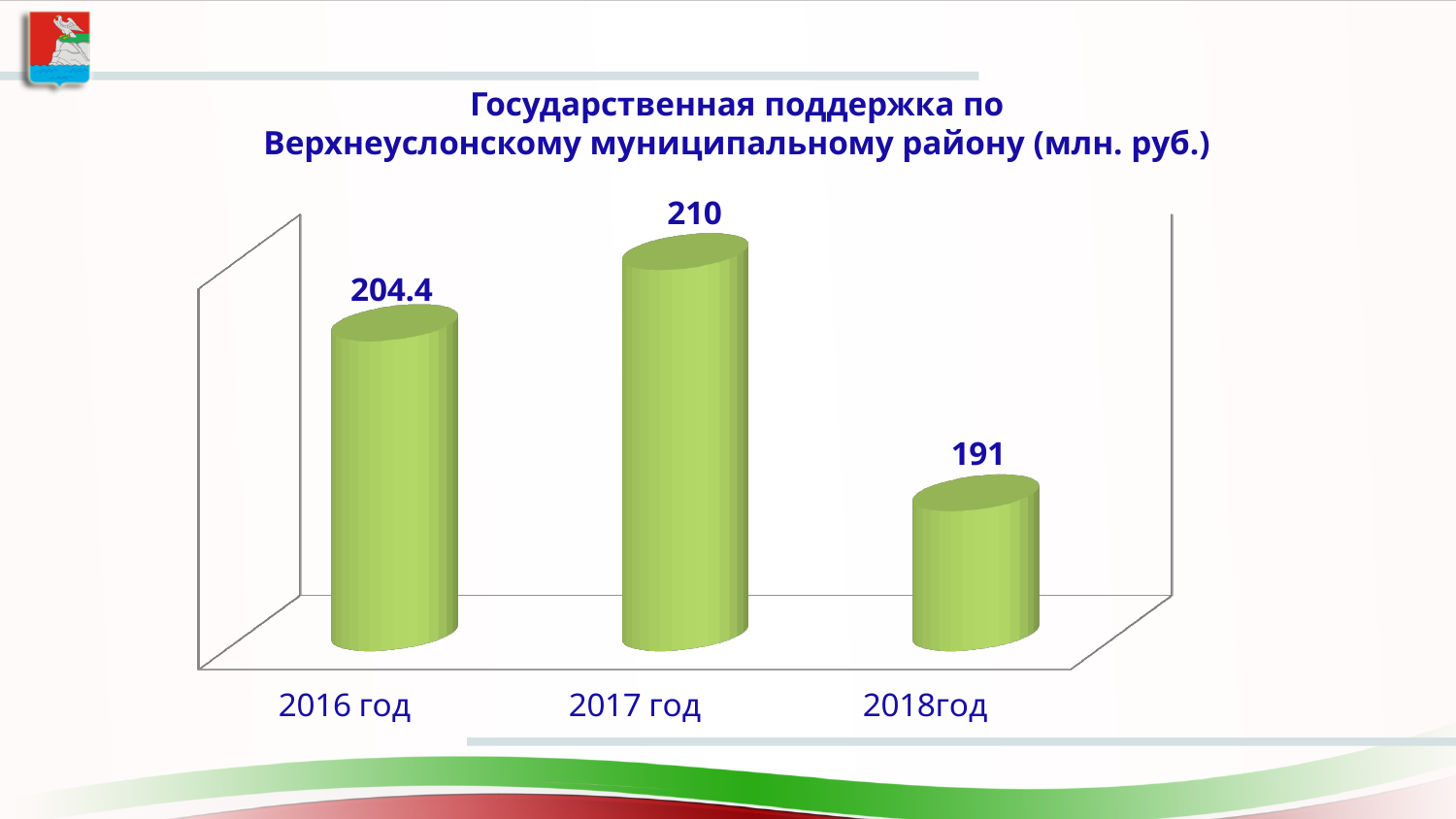
What is the difference between the values for 2017 год and 2016 год? 5.6 What is the value for 2018год? 191 Which year has the lowest value? 2018год What is the value for 2017 год? 210 How many years are shown on the chart? 3 What unit is given in the chart title? млн. руб. What is the value for 2016 год? 204.4 Does the value rise or fall from 2017 год to 2018год? fall Which year has the highest value? 2017 год What is the difference between the values for 2017 год and 2018год? 19 What kind of chart is shown on the slide? bar chart Which is larger, the value for 2016 год or the value for 2018год? 2016 год